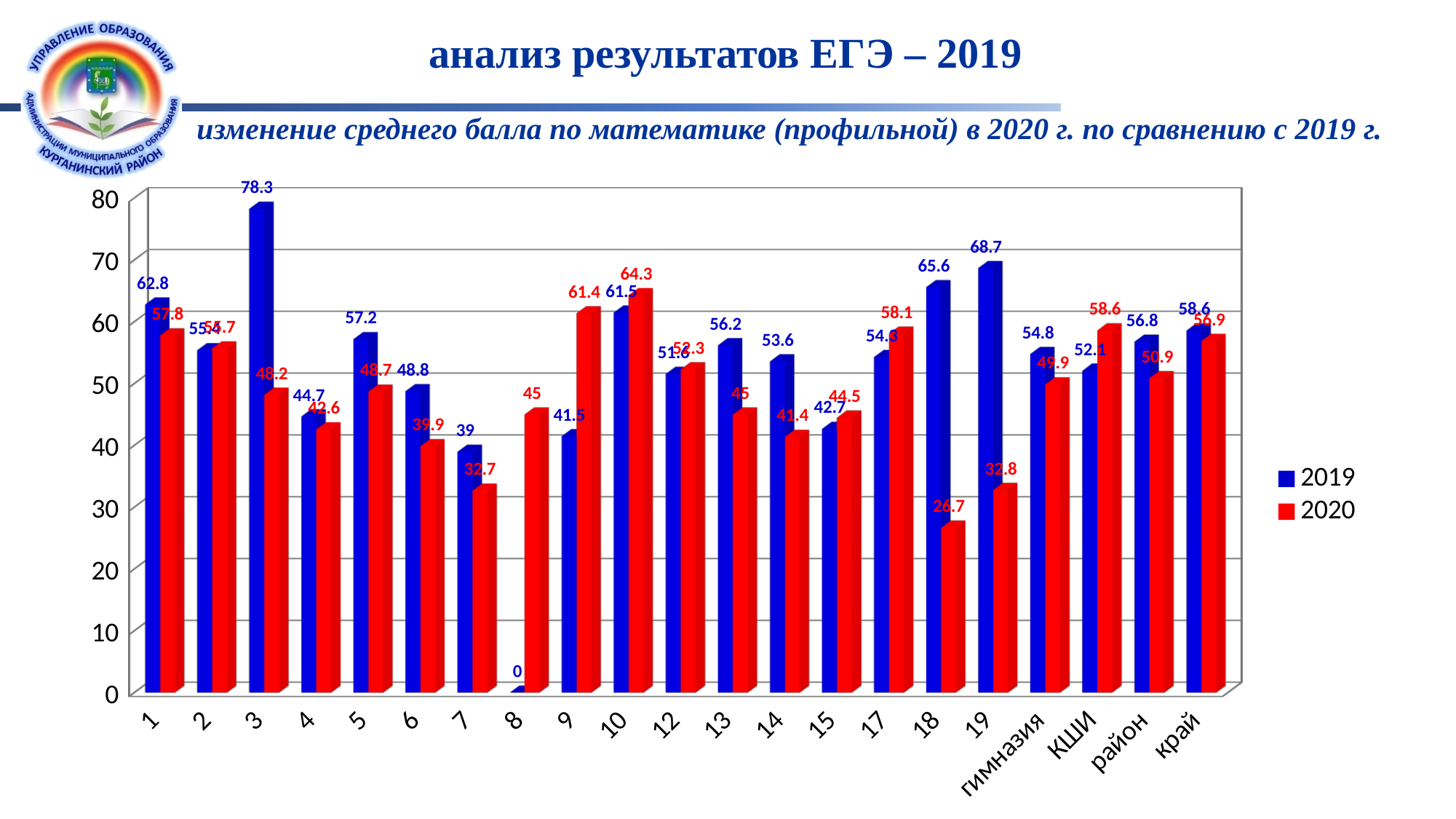
For КШИ, which is larger: the 2019 value or the 2020 value? 2020 Which category has the highest 2020 value? 10 What is the 2019 value for category 3? 78.3 What is the difference between the 2019 and 2020 values for category 19? 35.9 What type of chart is shown on the slide? bar chart What is the 2020 value for category 18? 26.7 Which category has the lowest 2020 value? 18 How many categories are shown on the x axis? 21 Which colour represents the 2020 series in the legend? red How many series does the legend list? 2 What is the 2020 value for край? 56.9 Which category has the highest 2019 value? 3